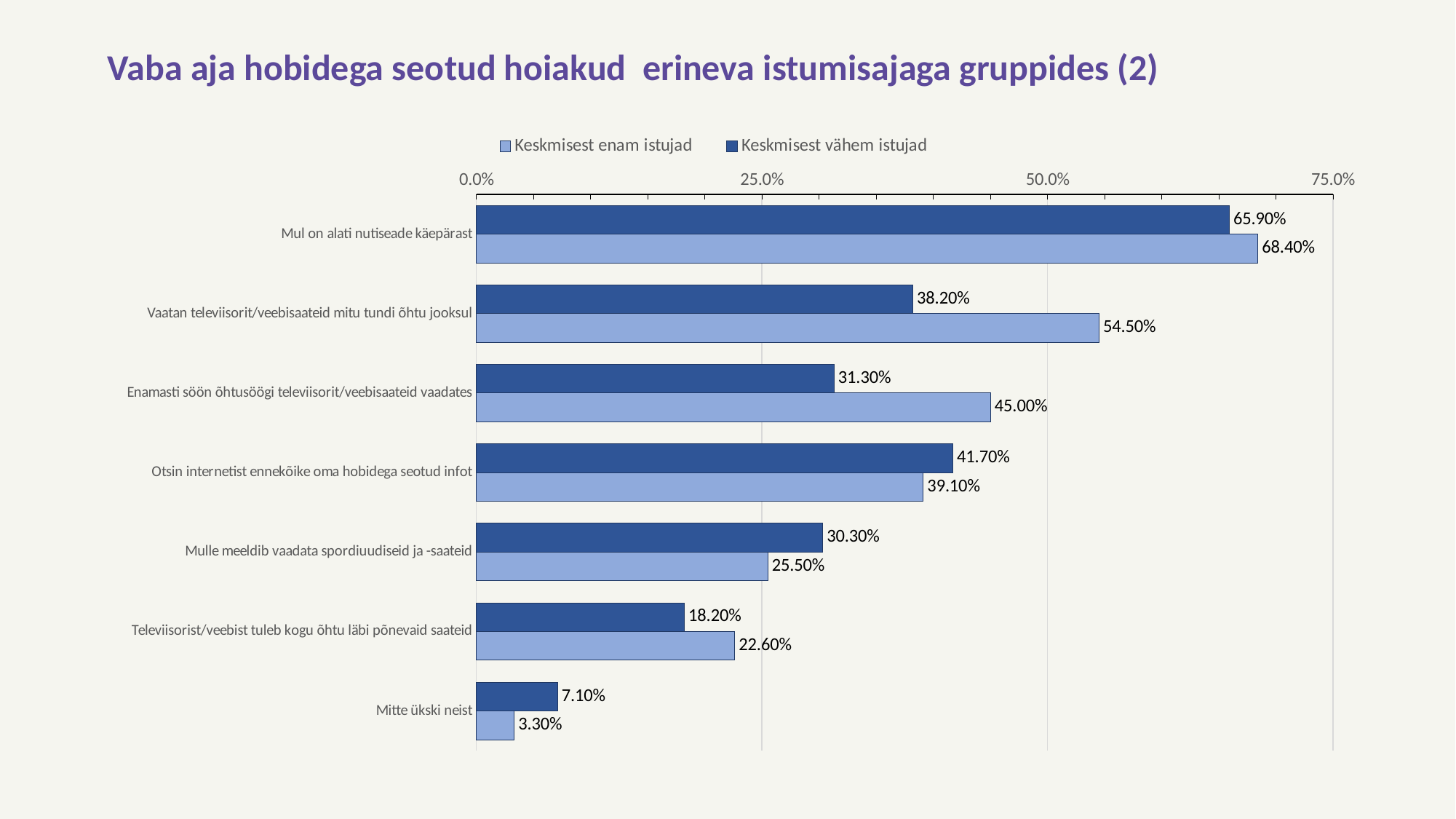
Is the value for "Keskmisest enam istujad" in the category "Enamasti söön õhtusöögi televiisorit/veebisaateid vaadates" greater or less than 25.0%? greater What type of chart is shown on the slide? Bar chart Which category has the highest value for "Keskmisest vähem istujad"? Mul on alati nutiseade käepärast What is the value for "Keskmisest enam istujad" in the category "Mul on alati nutiseade käepärast"? 68.40% What is the difference between "Keskmisest enam istujad" and "Keskmisest vähem istujad" in the category "Vaatan televiisorit/veebisaateid mitu tundi õhtu jooksul"? 16.30% Which category has the lowest value for "Keskmisest enam istujad"? Mitte ükski neist What is the title of the chart on the slide? Vaba aja hobidega seotud hoiakud erineva istumisajaga gruppides (2) What is the value for "Keskmisest vähem istujad" in the category "Vaatan televiisorit/veebisaateid mitu tundi õhtu jooksul"? 38.20% How many series does the legend list? 2 What is the value for "Keskmisest enam istujad" in the category "Mitte ükski neist"? 3.30% In the category "Otsin internetist ennekõike oma hobidega seotud infot", which series has the larger value? Keskmisest vähem istujad How many categories are shown on the chart? 7